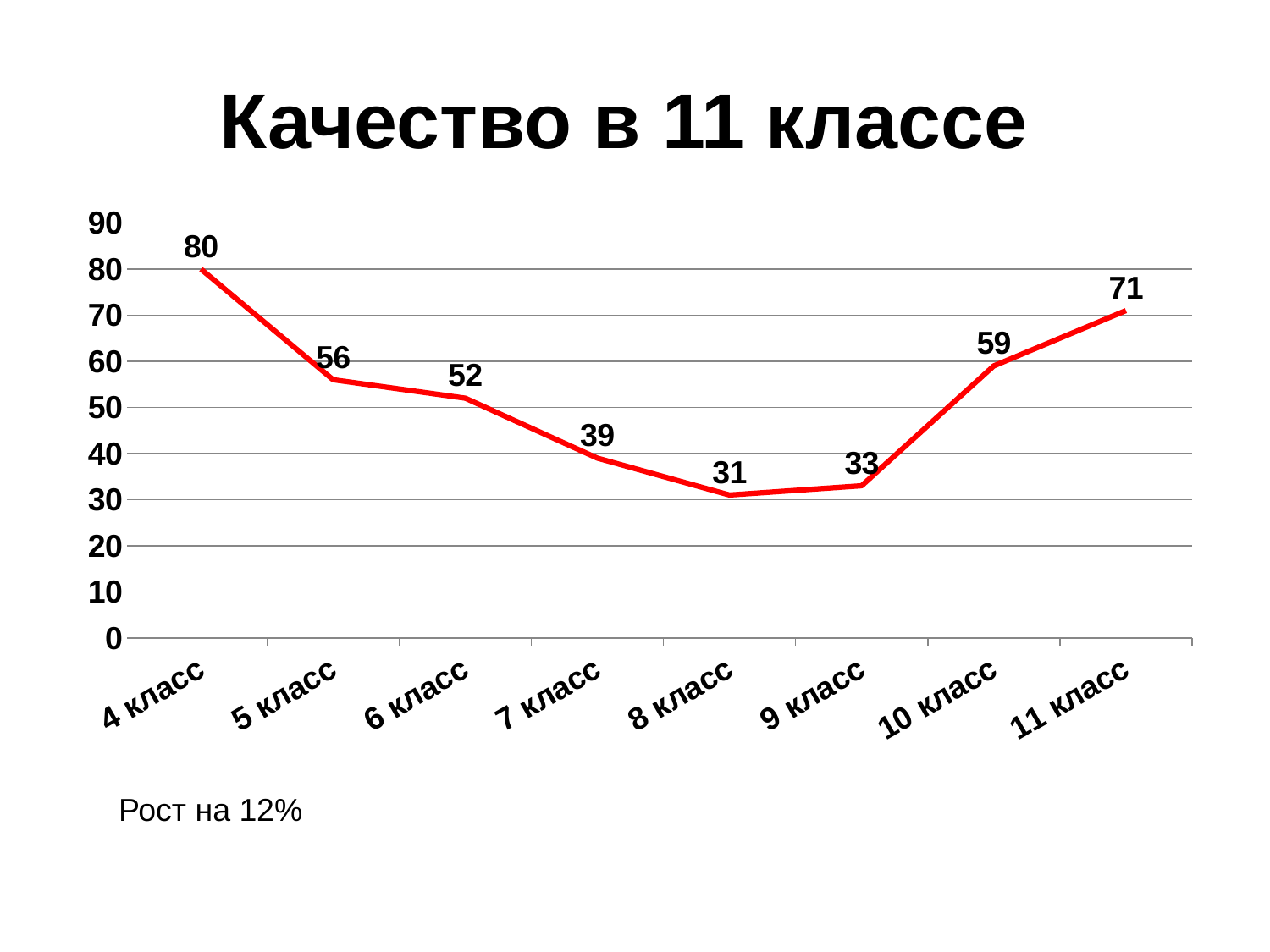
What is the value for 11 класс? 71 What kind of chart is shown on the slide? line chart Which category has the highest value? 4 класс Do the values rise or fall from 4 класс to 8 класс? fall What is the value for 8 класс? 31 What is the difference between the values for 11 класс and 10 класс? 12 What is the difference between the values for 4 класс and 8 класс? 49 How many categories are plotted on the x axis? 8 Which category has the lowest value? 8 класс Which is larger, the value for 5 класс or the value for 6 класс? 5 класс What is the title of the chart? Качество в 11 классе What is the value for 4 класс? 80